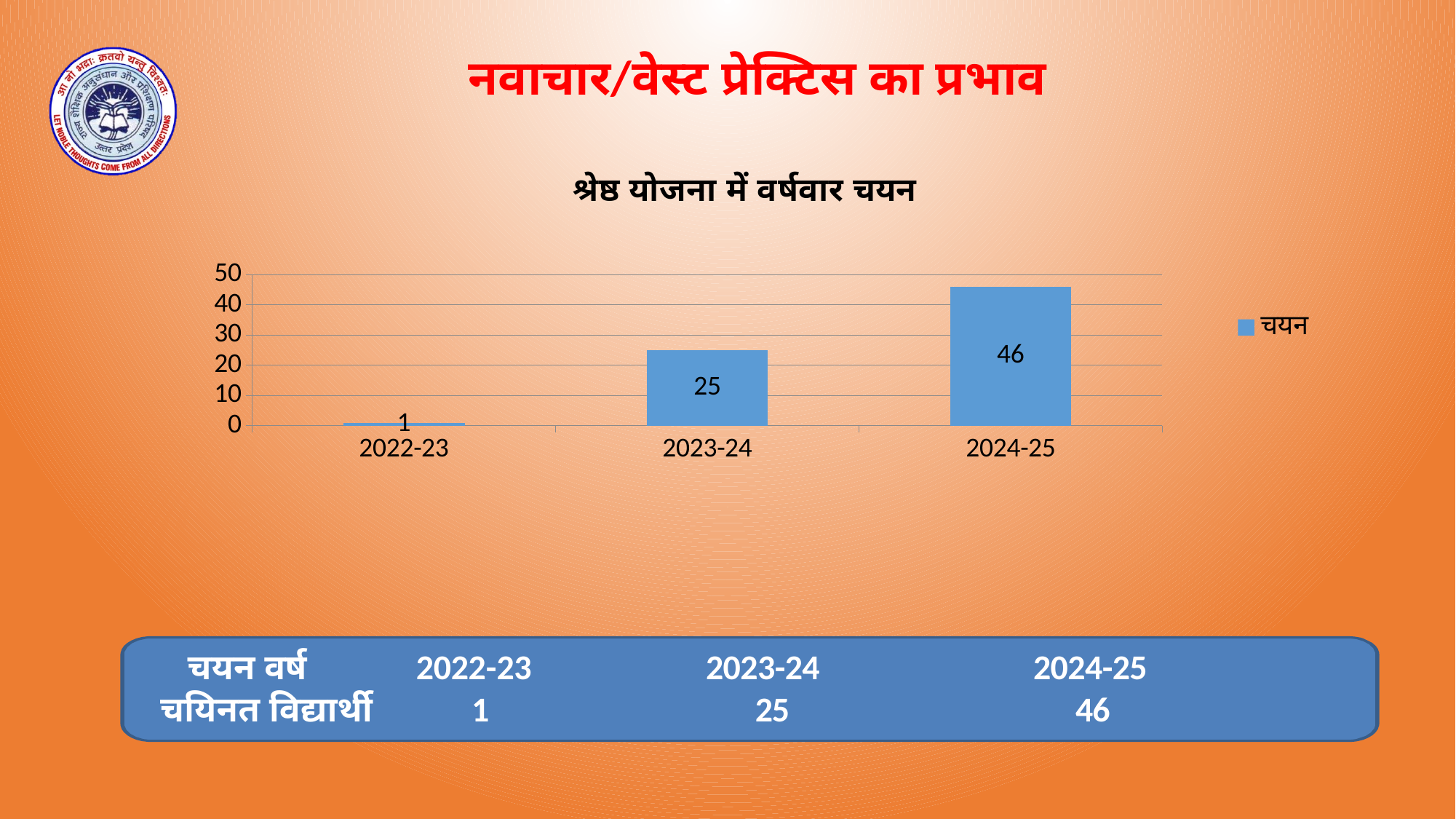
How many years are shown on the x axis? 3 What is the difference between the values for 2023-24 and 2022-23? 24 Which is larger, the value for 2023-24 or the value for 2024-25? 2024-25 Which year has the highest value? 2024-25 Do the values rise or fall from 2022-23 to 2024-25? rise What is the value for 2023-24? 25 What is the value for 2024-25? 46 What is the value for 2022-23? 1 Is the value for 2024-25 greater or less than 40? greater What is the difference between the values for 2024-25 and 2023-24? 21 What kind of chart is shown? bar chart Which year has the lowest value? 2022-23